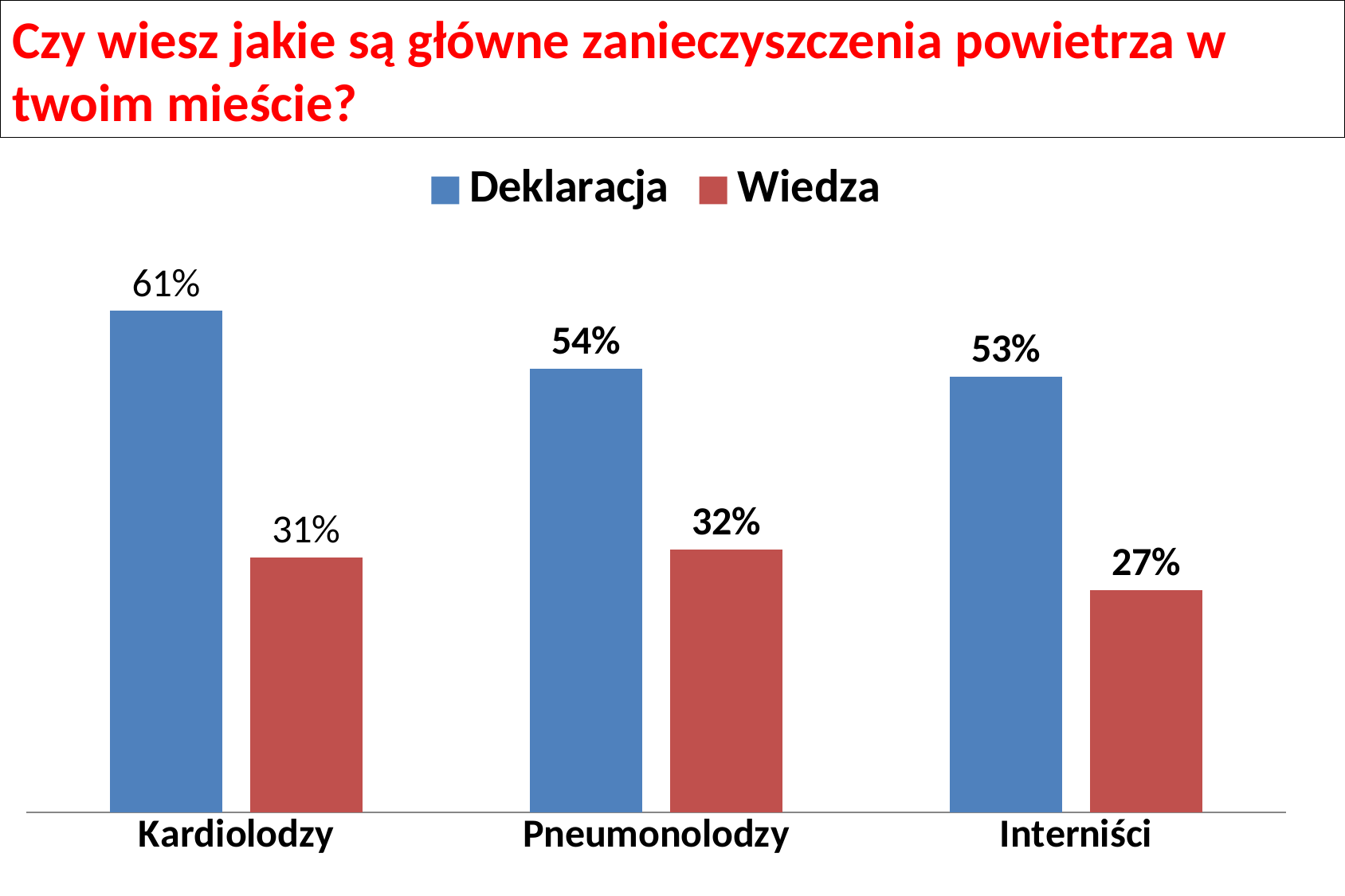
Which category has the highest Deklaracja value? Kardiolodzy Which colour represents the Wiedza series? Red What kind of chart is shown on the slide? Bar chart What is the difference between the Deklaracja and Wiedza values for Kardiolodzy? 30% How many series does the legend list? 2 How many categories are shown on the x axis? 3 Which is larger: the Wiedza value for Kardiolodzy or the Wiedza value for Interniści? Kardiolodzy What is the Deklaracja value for Kardiolodzy? 61% What is the Wiedza value for Pneumonolodzy? 32% Which category has the lowest Wiedza value? Interniści What is the Wiedza value for Interniści? 27% What is the difference between the Deklaracja values for Pneumonolodzy and Interniści? 1%